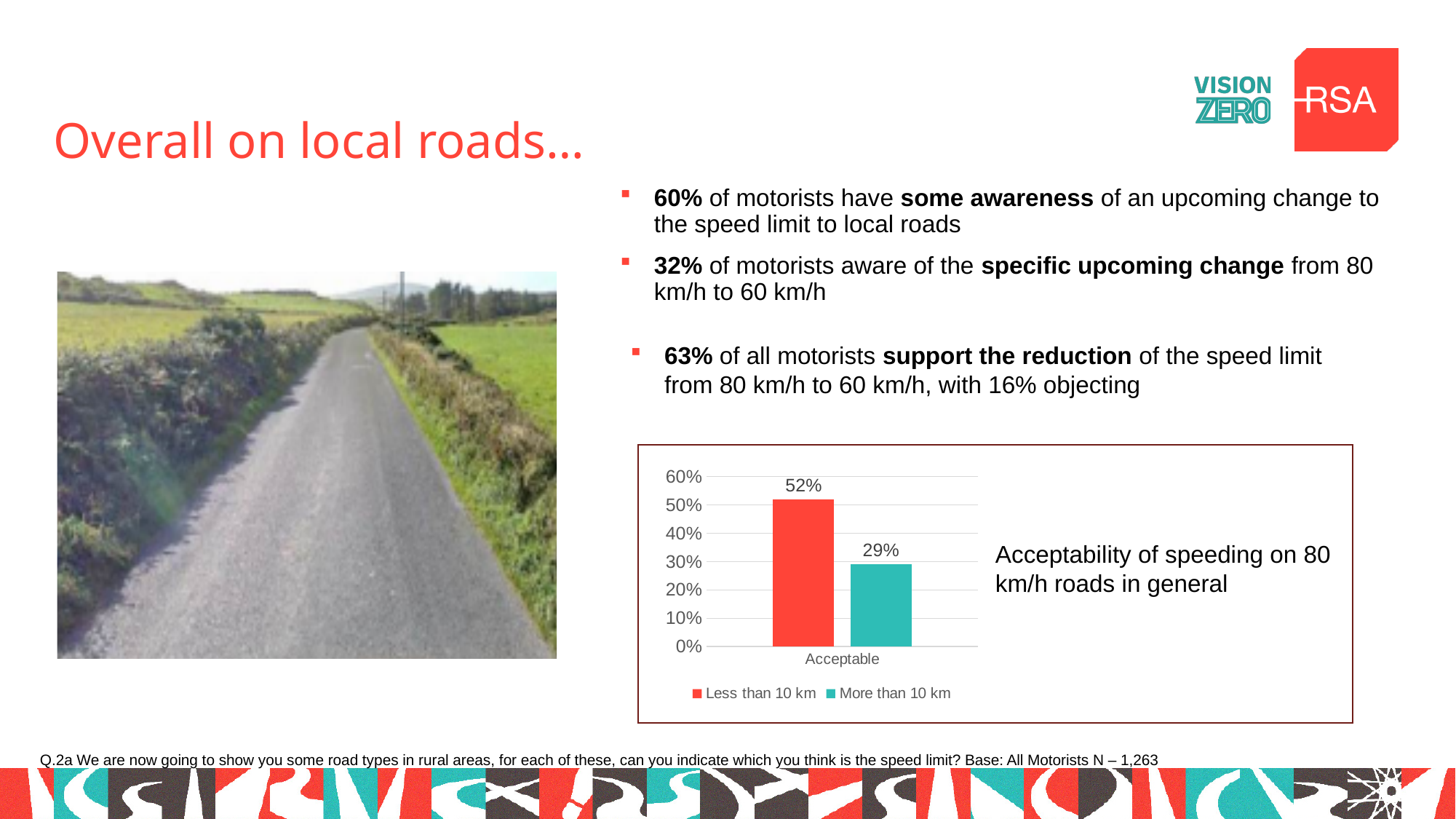
Which series has the highest value in the chart? Less than 10 km How many categories are shown on the x axis of the chart? 1 Which series has the lowest value in the chart? More than 10 km Is the value for 'Less than 10 km' greater or less than 50%? greater Is the value for 'More than 10 km' greater or less than 30%? less How many series does the legend list? 2 What is the value for 'Less than 10 km' in the Acceptable category? 52% Which series has the higher value for Acceptable: 'Less than 10 km' or 'More than 10 km'? Less than 10 km What is the label of the category on the x axis? Acceptable What is the value for 'More than 10 km' in the Acceptable category? 29% What is the difference between the 'Less than 10 km' and 'More than 10 km' values? 23% What kind of chart is shown on the slide? Bar chart